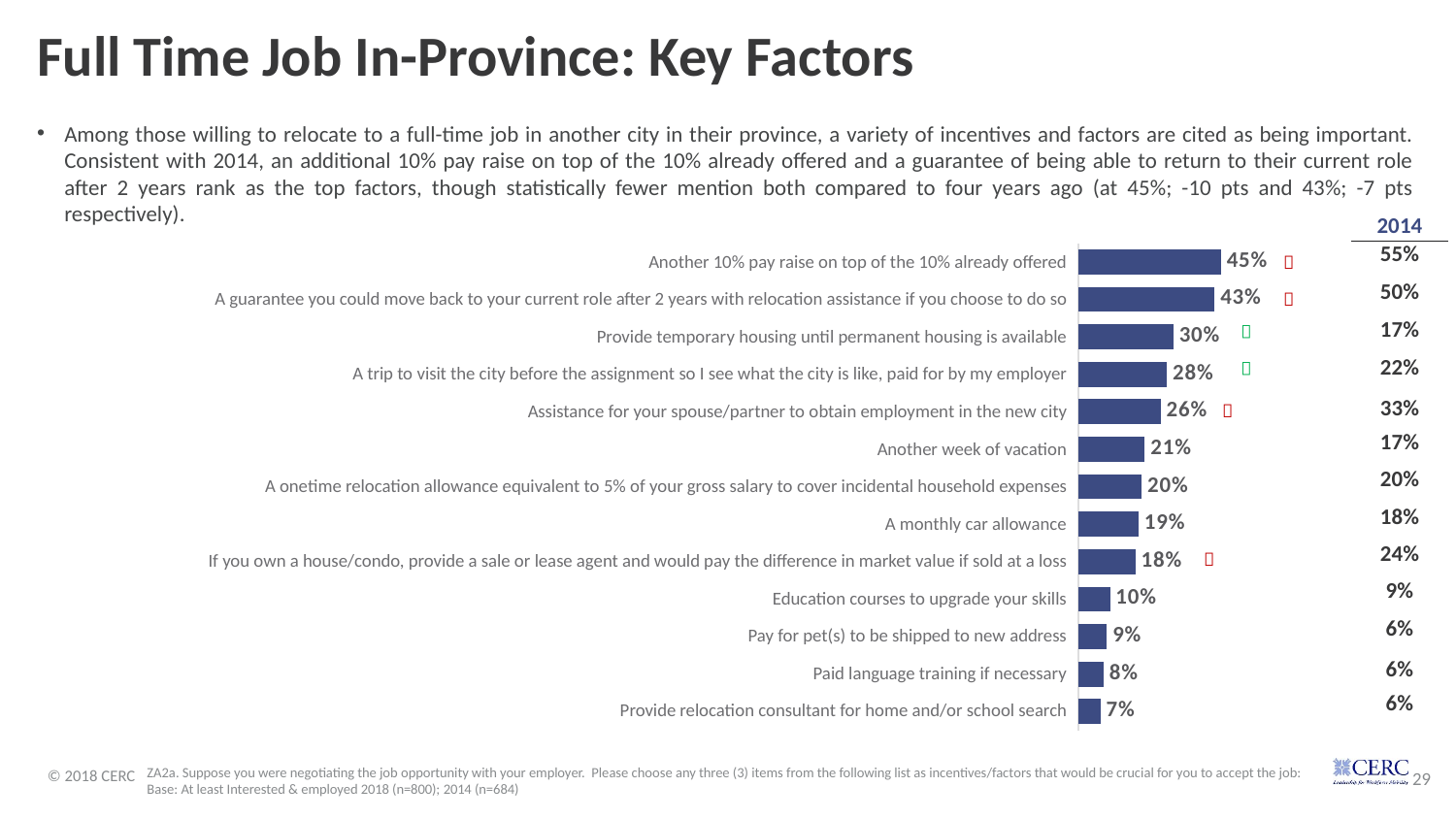
What is the difference between the values for "A trip to visit the city before the assignment so I see what the city is like, paid for by my employer" and "Paid language training if necessary"? 20 percentage points What is the value shown for "Another week of vacation"? 21% What is the value shown for "Pay for pet(s) to be shipped to new address"? 9% Which is larger: the value for "A monthly car allowance" or the value for "Education courses to upgrade your skills"? A monthly car allowance What is the value shown for "Provide temporary housing until permanent housing is available"? 30% Which factor has the highest value in the chart? Another 10% pay raise on top of the 10% already offered What percentage of respondents cited "Another 10% pay raise on top of the 10% already offered" as a key factor? 45% What is the difference between the values for "Another 10% pay raise on top of the 10% already offered" and "A guarantee you could move back to your current role after 2 years with relocation assistance if you choose to do so"? 2 percentage points What type of chart is shown on the slide? Bar chart Which factor has the lowest value in the chart? Provide relocation consultant for home and/or school search How many factors (bars) are shown in the chart? 13 What year is shown as the header of the comparison column to the right of the chart? 2014